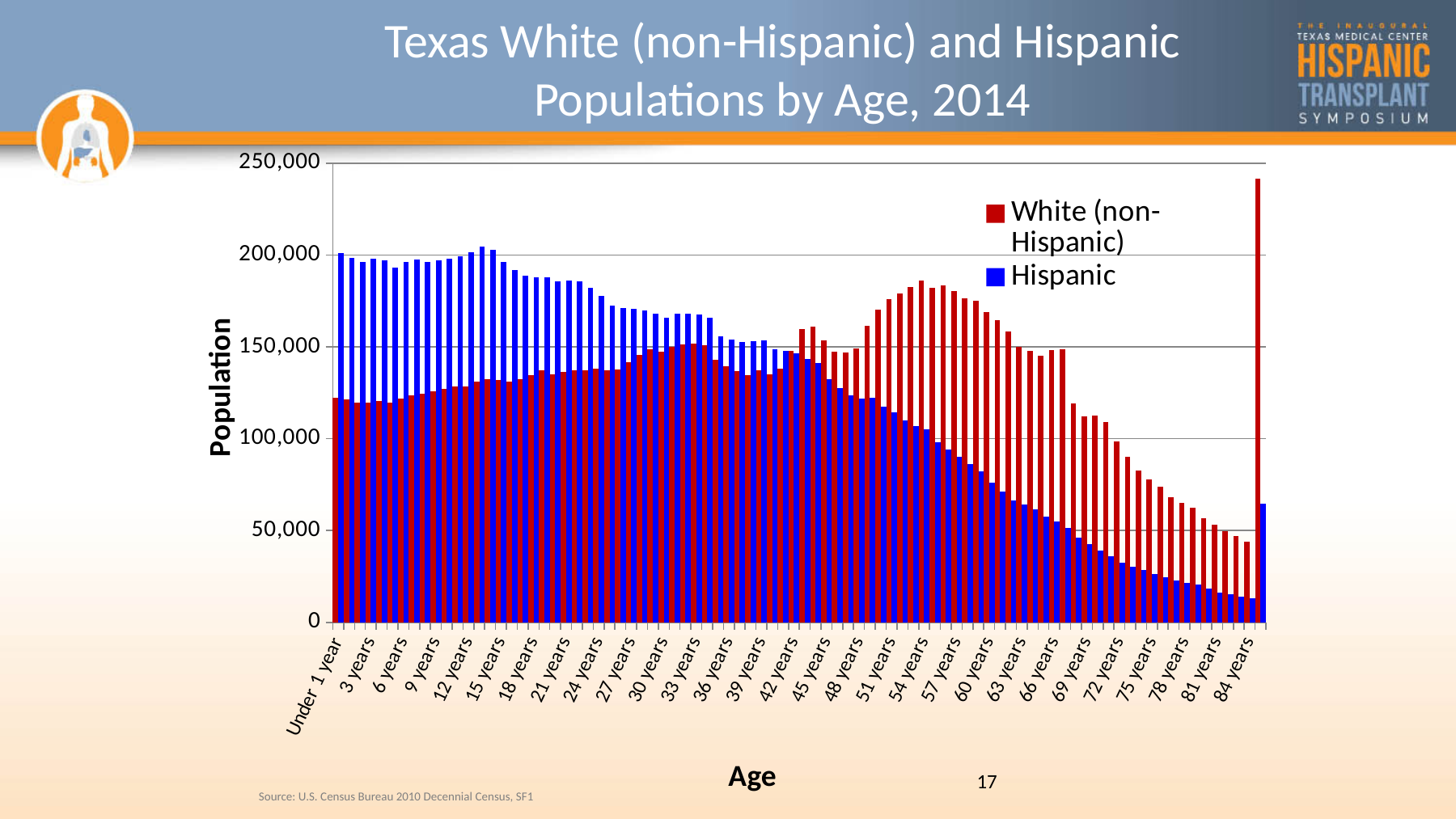
At 6 years, which series has the larger value, White (non-Hispanic) or Hispanic? Hispanic Is the White (non-Hispanic) value for Under 1 year greater or less than 100,000? greater Do the Hispanic values generally rise or fall from 15 years to 84 years along the x axis? fall Is the Hispanic value for 84 years greater or less than 50,000? less How many series does the legend list? 2 Which series is shown in blue in the legend? Hispanic Is the Hispanic value for 30 years greater or less than 150,000? greater What kind of chart is shown on the slide? Bar chart What is the label of the vertical axis? Population At 54 years, which series has the larger value, White (non-Hispanic) or Hispanic? White (non-Hispanic)